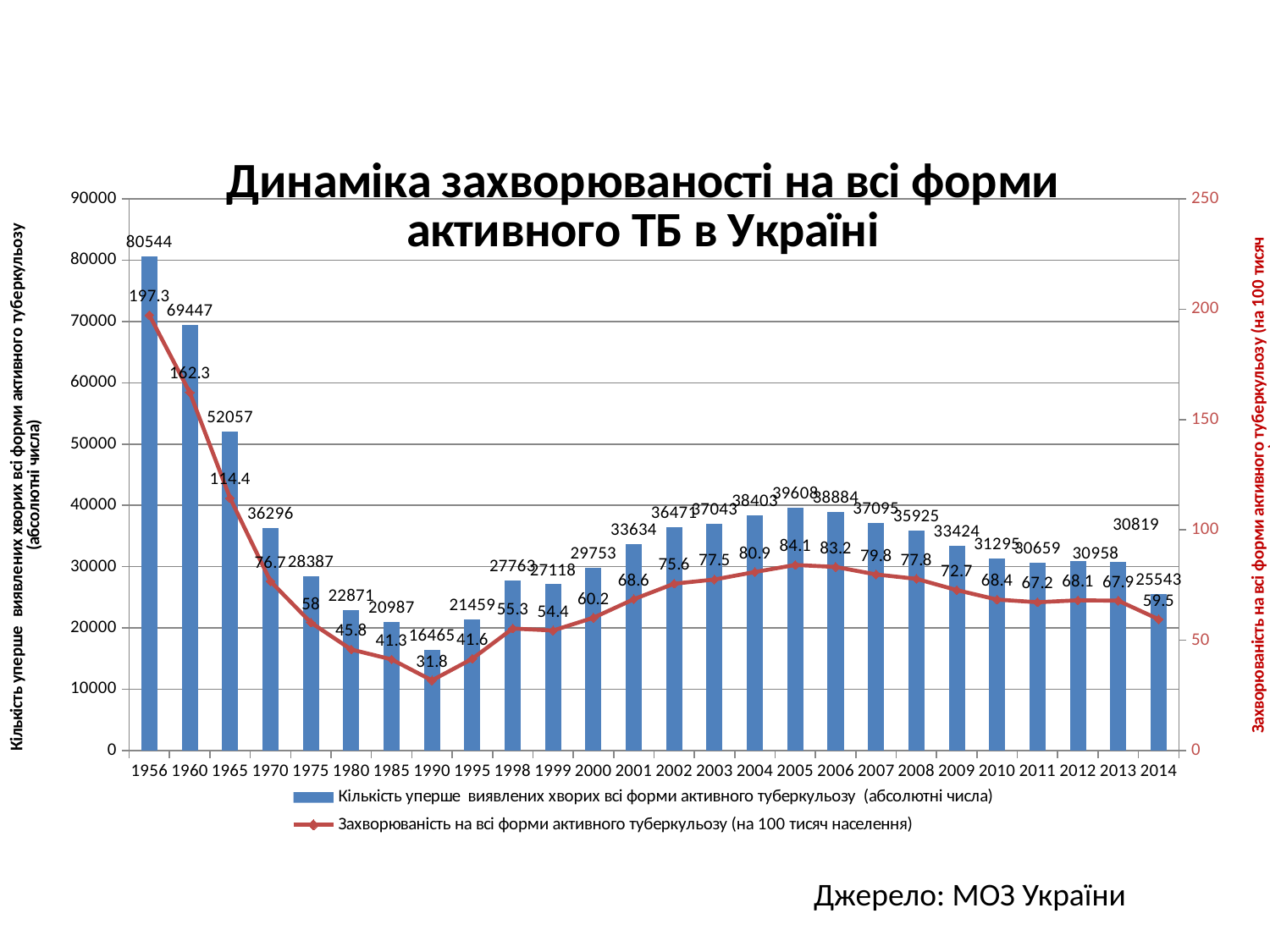
What is the incidence per 100 thousand population in 1990? 31.8 Does the incidence per 100 thousand population rise or fall from 1956 to 1990? Fall What is the number of newly detected patients (absolute numbers) in 1956? 80544 How many years are shown on the x axis? 26 Which year has the larger number of newly detected patients, 2005 or 2006? 2005 Which year has the highest incidence per 100 thousand population? 1956 Which year has the lowest number of newly detected patients (absolute numbers)? 1990 How many series does the legend list? 2 What is the difference in the number of newly detected patients between 1956 and 1960? 11097 What is the incidence per 100 thousand population in 2005? 84.1 What kinds of chart are combined on this slide? A bar chart and a line chart What is the number of newly detected patients (absolute numbers) in 2014? 25543